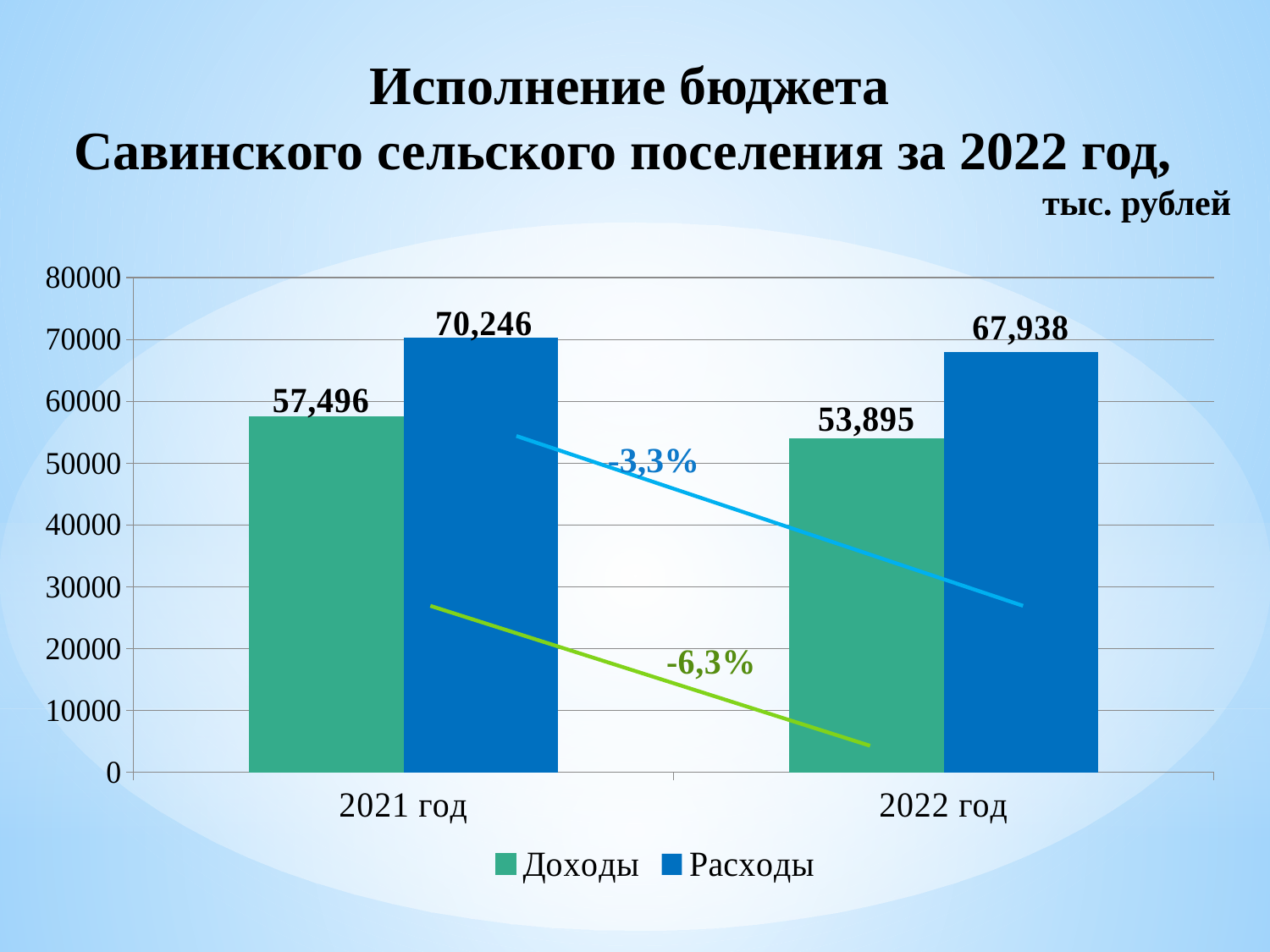
What percentage change is shown next to the green line on the chart? -6,3% What is the value of Доходы for 2021 год? 57,496 What is the value of Расходы for 2022 год? 67,938 How many series does the legend list? 2 What is the value of Доходы for 2022 год? 53,895 What is the difference between Расходы and Доходы in 2022 год? 14,043 Which is larger in 2021 год, Доходы or Расходы? Расходы Which year has the higher value for Расходы? 2021 год What is the value of Расходы for 2021 год? 70,246 Do the values for Доходы rise or fall from 2021 год to 2022 год? Fall Which year has the lower value for Доходы? 2022 год What kind of chart is shown on the slide? Bar chart